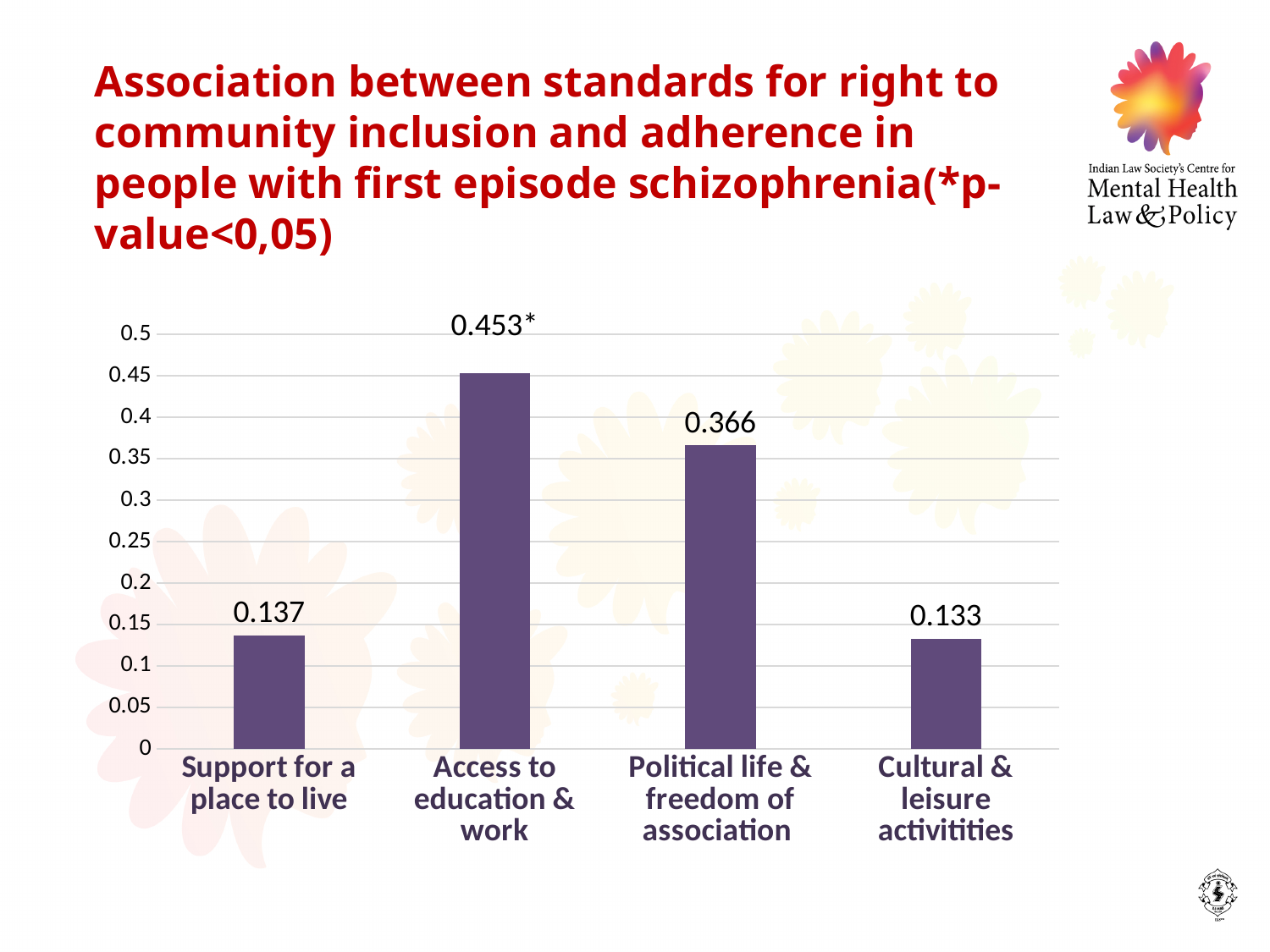
What is the value for Access to education & work? 0.453* What is the value for Cultural & leisure activities? 0.133 What is the difference between the values for Access to education & work and Political life & freedom of association? 0.087 What is the difference between the values for Access to education & work and Cultural & leisure activities? 0.320 What is the value for Political life & freedom of association? 0.366 What is the value for Support for a place to live? 0.137 Is the value for Political life & freedom of association greater or less than 0.3? greater How many categories are shown in the chart? 4 Which category has the highest value? Access to education & work What kind of chart is shown on the slide? Bar chart Which category has the lowest value? Cultural & leisure activities Which is larger, the value for Political life & freedom of association or the value for Support for a place to live? Political life & freedom of association